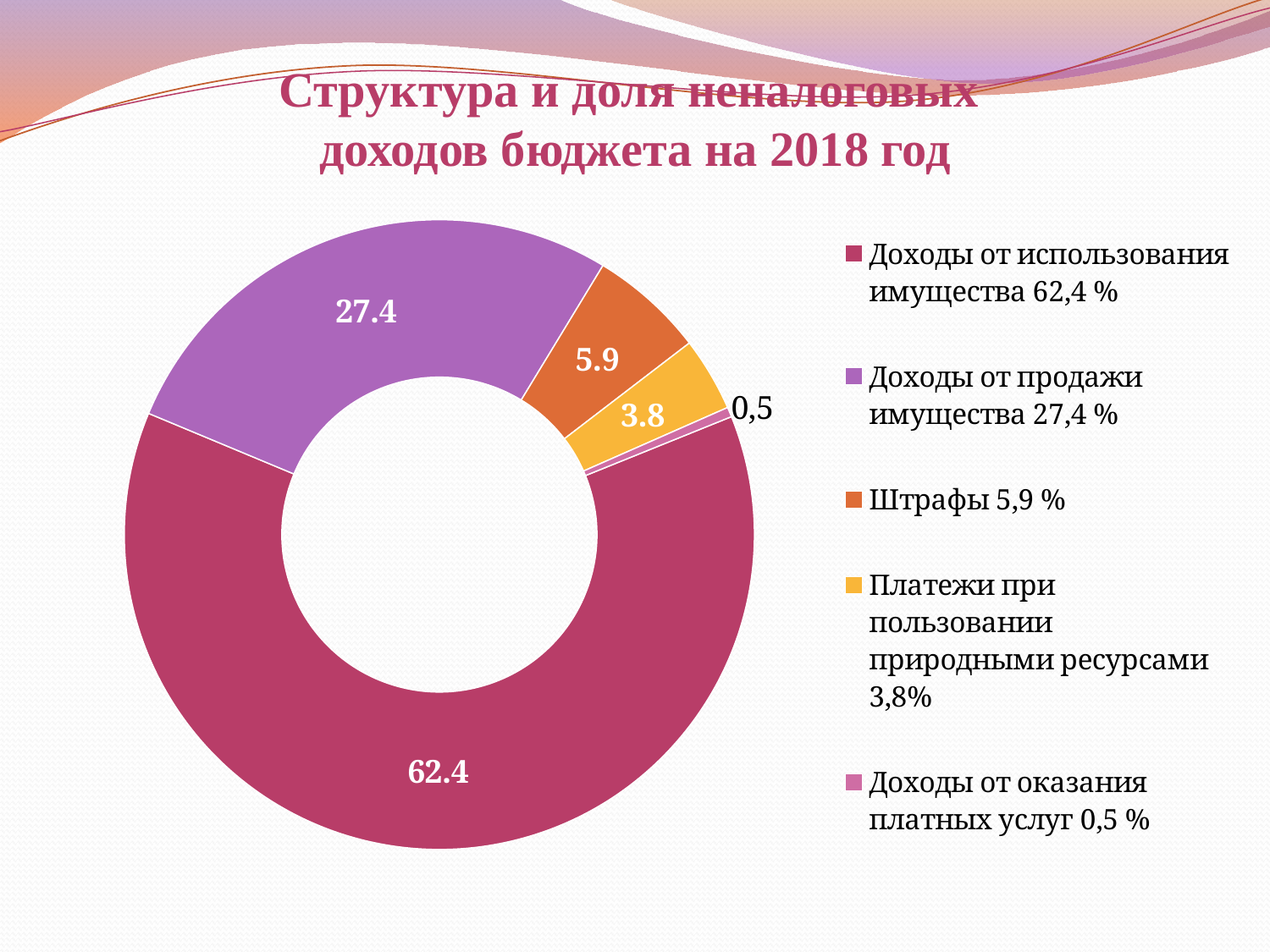
How many slices does the chart have? 5 Which is larger: the value for 'Штрафы' or the value for 'Платежи при пользовании природными ресурсами'? Штрафы What is the difference between the values for 'Доходы от использования имущества' and 'Доходы от продажи имущества'? 35 What value is shown for the slice 'Платежи при пользовании природными ресурсами'? 3.8 What kind of chart is shown on the slide? Doughnut (pie) chart What is the difference between the values for 'Доходы от продажи имущества' and 'Штрафы'? 21.5 Which category has the largest slice of the chart? Доходы от использования имущества What value is shown for the slice 'Штрафы'? 5.9 What value is shown for the slice 'Доходы от оказания платных услуг'? 0,5 What is the title of the slide? Структура и доля неналоговых доходов бюджета на 2018 год Which category has the smallest slice of the chart? Доходы от оказания платных услуг What value is shown for the slice 'Доходы от использования имущества'? 62.4